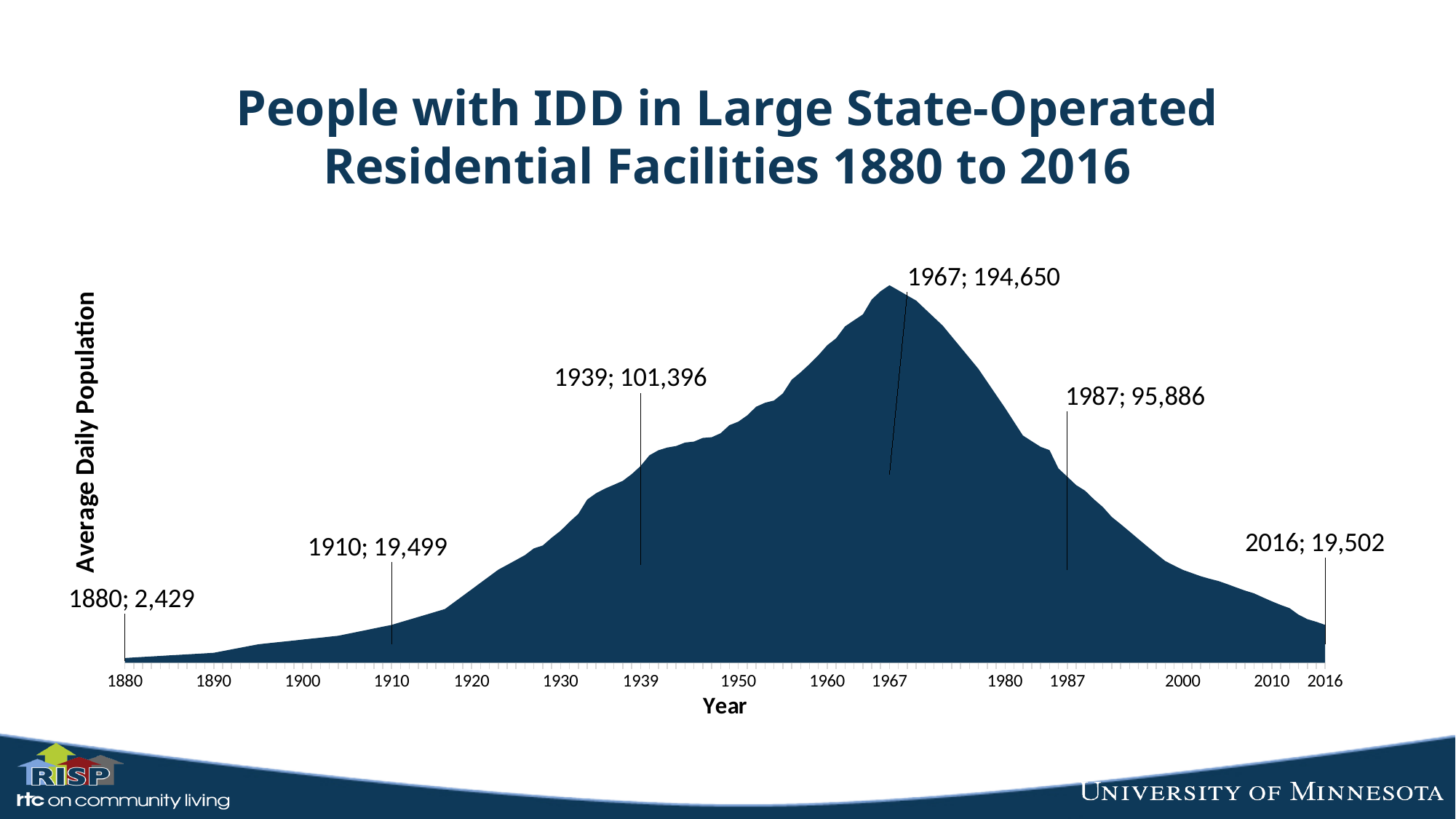
In which labeled year was the average daily population lowest? 1880 What was the average daily population in 1880? 2,429 What kind of chart is shown on the slide? Area chart Does the average daily population rise or fall between 1967 and 2016? Fall What was the average daily population in 1967? 194,650 How many data points have value labels on the chart? 6 What was the average daily population in 2016? 19,502 Which is larger, the value for 1939 or the value for 1987? 1939 What was the average daily population in 1939? 101,396 What is the difference between the 1967 value and the 1987 value? 98,764 What is the difference between the 2016 value and the 1880 value? 17,073 In which labeled year was the average daily population highest? 1967